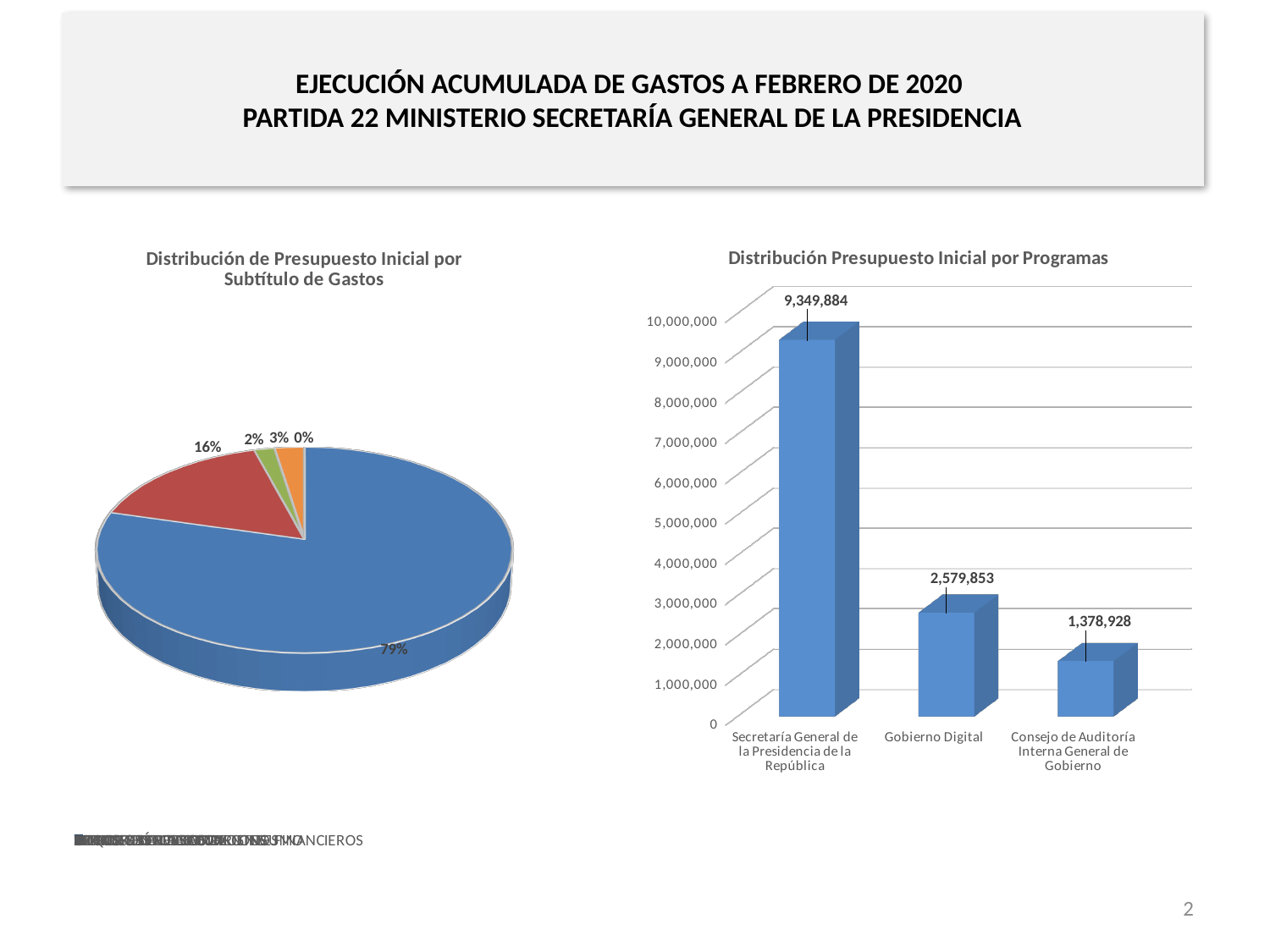
In the chart titled "Distribución Presupuesto Inicial por Programas", what is the value for Gobierno Digital? 2,579,853 What kind of chart is "Distribución Presupuesto Inicial por Programas"? Bar chart In the chart titled "Distribución Presupuesto Inicial por Programas", which is larger: the value for Gobierno Digital or the value for Consejo de Auditoría Interna General de Gobierno? Gobierno Digital What kind of chart is "Distribución de Presupuesto Inicial por Subtítulo de Gastos"? Pie chart In the chart titled "Distribución Presupuesto Inicial por Programas", how many programs are shown? 3 In the chart titled "Distribución Presupuesto Inicial por Programas", which program has the highest value? Secretaría General de la Presidencia de la República In the chart titled "Distribución Presupuesto Inicial por Programas", which program has the lowest value? Consejo de Auditoría Interna General de Gobierno In the chart titled "Distribución Presupuesto Inicial por Programas", what is the difference between the values for Gobierno Digital and Consejo de Auditoría Interna General de Gobierno? 1,200,925 In the pie chart titled "Distribución de Presupuesto Inicial por Subtítulo de Gastos", what share does the largest slice have? 79% In the chart titled "Distribución Presupuesto Inicial por Programas", what is the value for Secretaría General de la Presidencia de la República? 9,349,884 In the chart titled "Distribución Presupuesto Inicial por Programas", do the values rise or fall from left to right? Fall In the chart titled "Distribución Presupuesto Inicial por Programas", what is the value for Consejo de Auditoría Interna General de Gobierno? 1,378,928